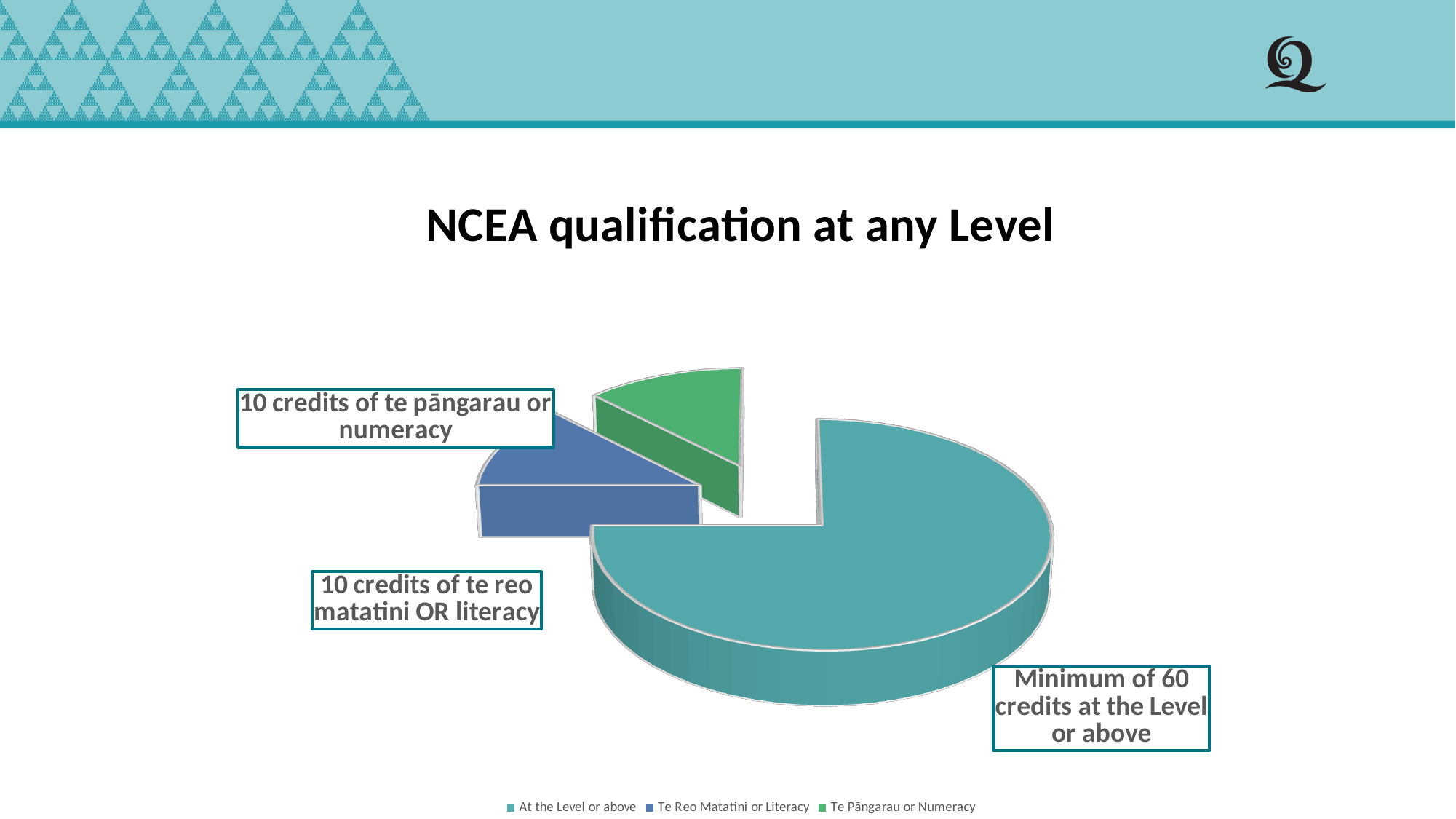
How many slices does the pie chart have? 3 What data label is attached to the 'At the Level or above' slice? Minimum of 60 credits at the Level or above What is the title of the chart? NCEA qualification at any Level Which slice of the pie chart is the largest? At the Level or above How many entries does the legend list? 3 What data label is attached to the 'Te Pāngarau or Numeracy' slice? 10 credits of te pāngarau or numeracy Is the 'At the Level or above' slice more or less than half of the pie? more What data label is attached to the 'Te Reo Matatini or Literacy' slice? 10 credits of te reo matatini OR literacy What colour is the 'Te Pāngarau or Numeracy' slice? Green Which is larger: the 'Te Pāngarau or Numeracy' slice or the 'At the Level or above' slice? At the Level or above Which is larger: the 'At the Level or above' slice or the 'Te Reo Matatini or Literacy' slice? At the Level or above What kind of chart is shown on the slide? Pie chart